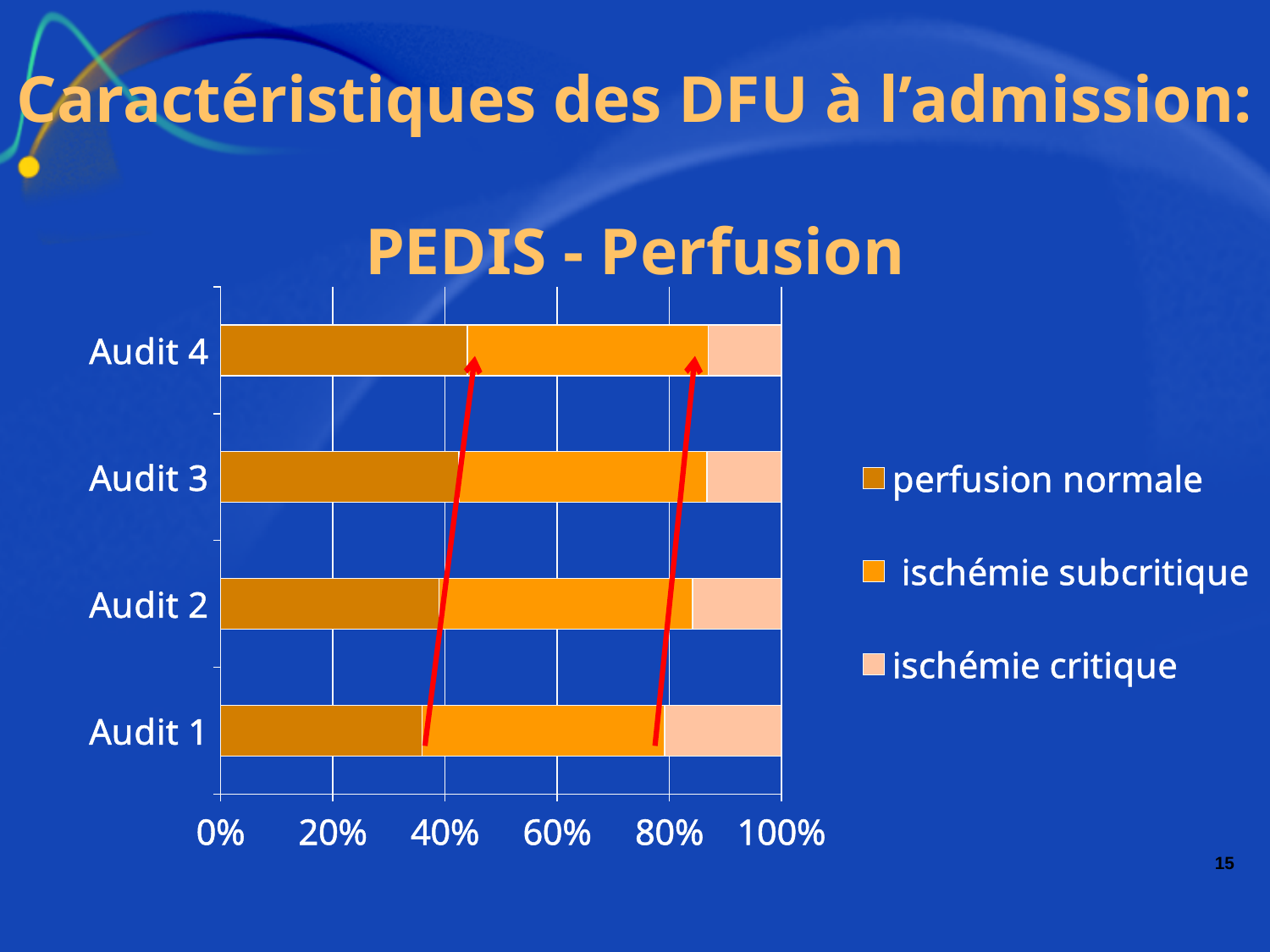
Does the share of perfusion normale rise or fall from Audit 1 to Audit 4? rise How many series does the legend list? 3 Is the share of perfusion normale for Audit 4 greater or less than 40%? greater How many audits (categories) are shown on the chart? 4 Is the share of ischémie critique for Audit 4 greater or less than 20%? less Which has a larger share of perfusion normale, Audit 1 or Audit 4? Audit 4 Is the share of perfusion normale for Audit 1 greater or less than 40%? less What is the title of the chart? PEDIS - Perfusion What kind of chart is shown on the slide? Stacked bar chart Which audit has the largest share of ischémie critique? Audit 1 Which series is listed first in the legend? perfusion normale